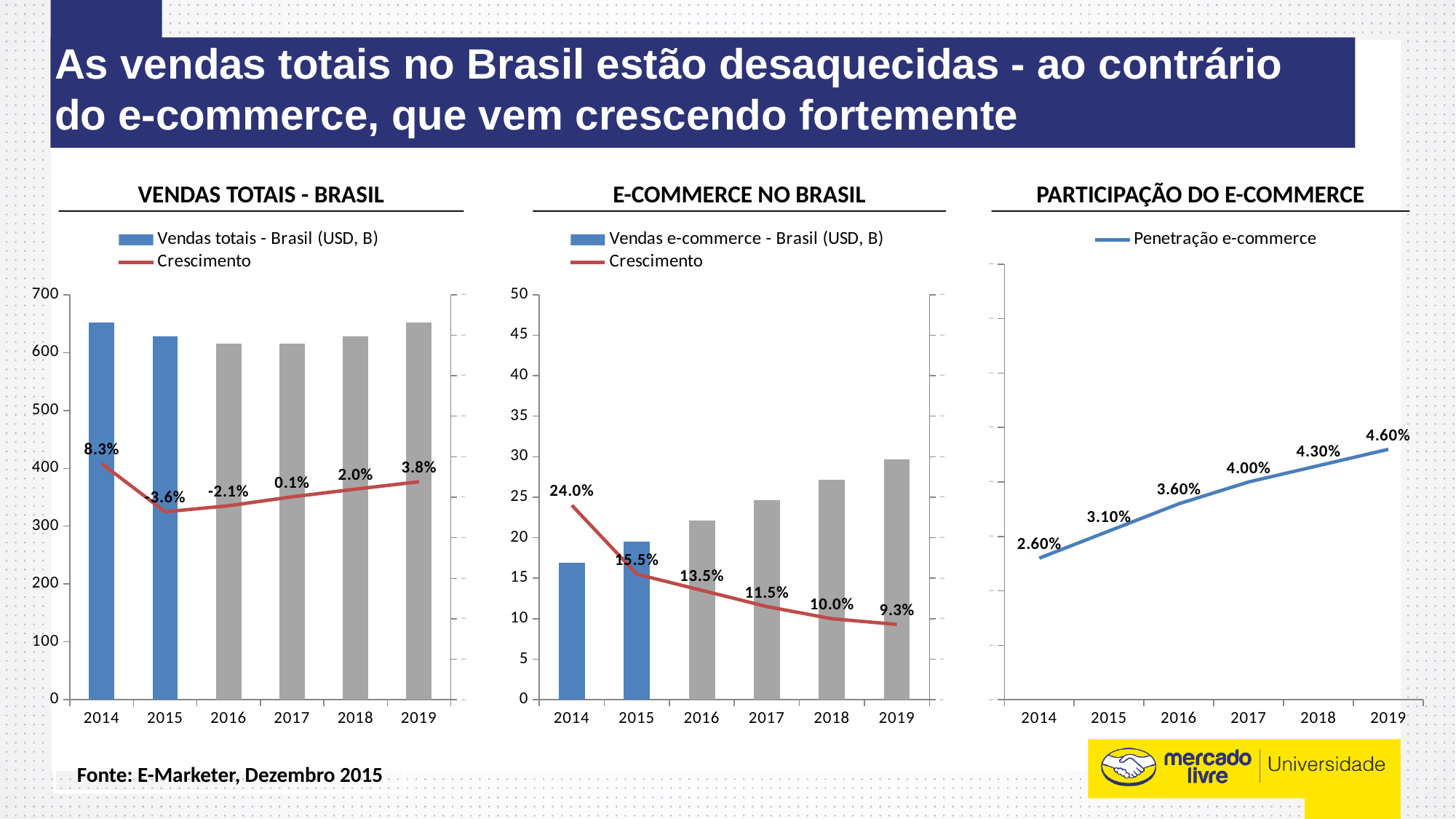
In the PARTICIPAÇÃO DO E-COMMERCE chart, what is the difference between the 2019 and 2014 values? 2.00% In the E-COMMERCE NO BRASIL chart, what is the Crescimento value for 2019? 9.3% In the VENDAS TOTAIS - BRASIL chart, which year has the lowest Crescimento value? 2015 What kind of chart is the PARTICIPAÇÃO DO E-COMMERCE chart? line chart In the E-COMMERCE NO BRASIL chart, does the Crescimento line rise or fall from 2014 to 2019? fall In the PARTICIPAÇÃO DO E-COMMERCE chart, what is the Penetração e-commerce value for 2017? 4.00% In the E-COMMERCE NO BRASIL chart, which bar is taller, 2014 or 2019? 2019 In the E-COMMERCE NO BRASIL chart, which year has the highest Crescimento value? 2014 In the E-COMMERCE NO BRASIL chart, is the bar for 2014 greater or less than 20? less In the VENDAS TOTAIS - BRASIL chart, what is the Crescimento value for 2014? 8.3% How many series does the legend of the VENDAS TOTAIS - BRASIL chart list? 2 In the VENDAS TOTAIS - BRASIL chart, is the bar for 2014 greater or less than 600? greater